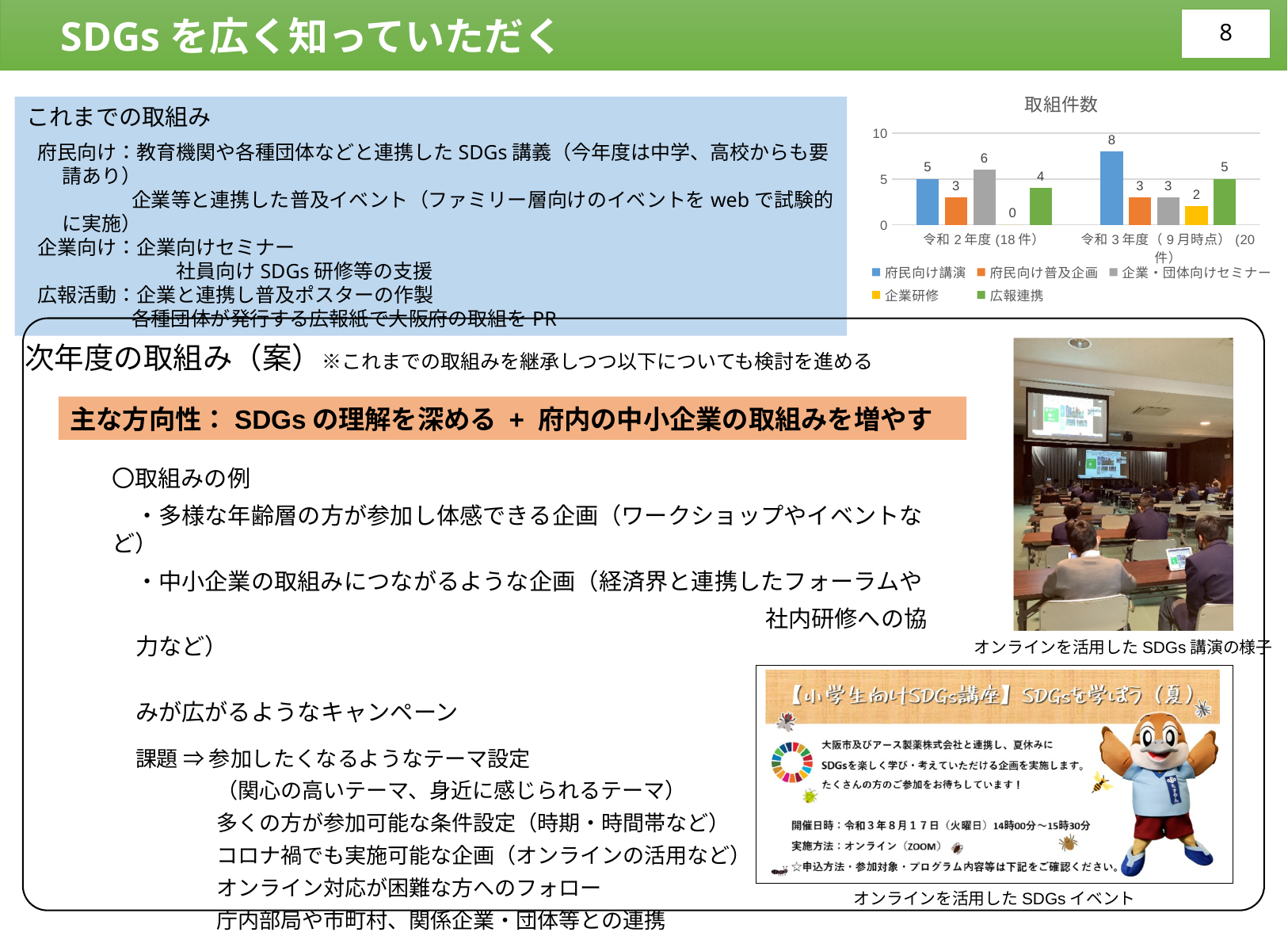
What is the value for 企業研修 in 令和２年度? 0 How many categories are shown on the x axis of the chart? 2 What is the value for 企業・団体向けセミナー in 令和２年度? 6 What is the title of the chart? 取組件数 Which is larger: 企業・団体向けセミナー in 令和２年度 or 企業・団体向けセミナー in 令和３年度（９月時点）? 令和２年度 What kind of chart is shown on the slide? bar chart Which series has the highest value in 令和３年度（９月時点）? 府民向け講演 What is the difference between 府民向け講演 in 令和３年度（９月時点） and 府民向け講演 in 令和２年度? 3 What is the value for 広報連携 in 令和３年度（９月時点）? 5 What is the value for 府民向け講演 in 令和３年度（９月時点）? 8 How many series does the chart legend list? 5 What is the value for 府民向け講演 in 令和２年度? 5